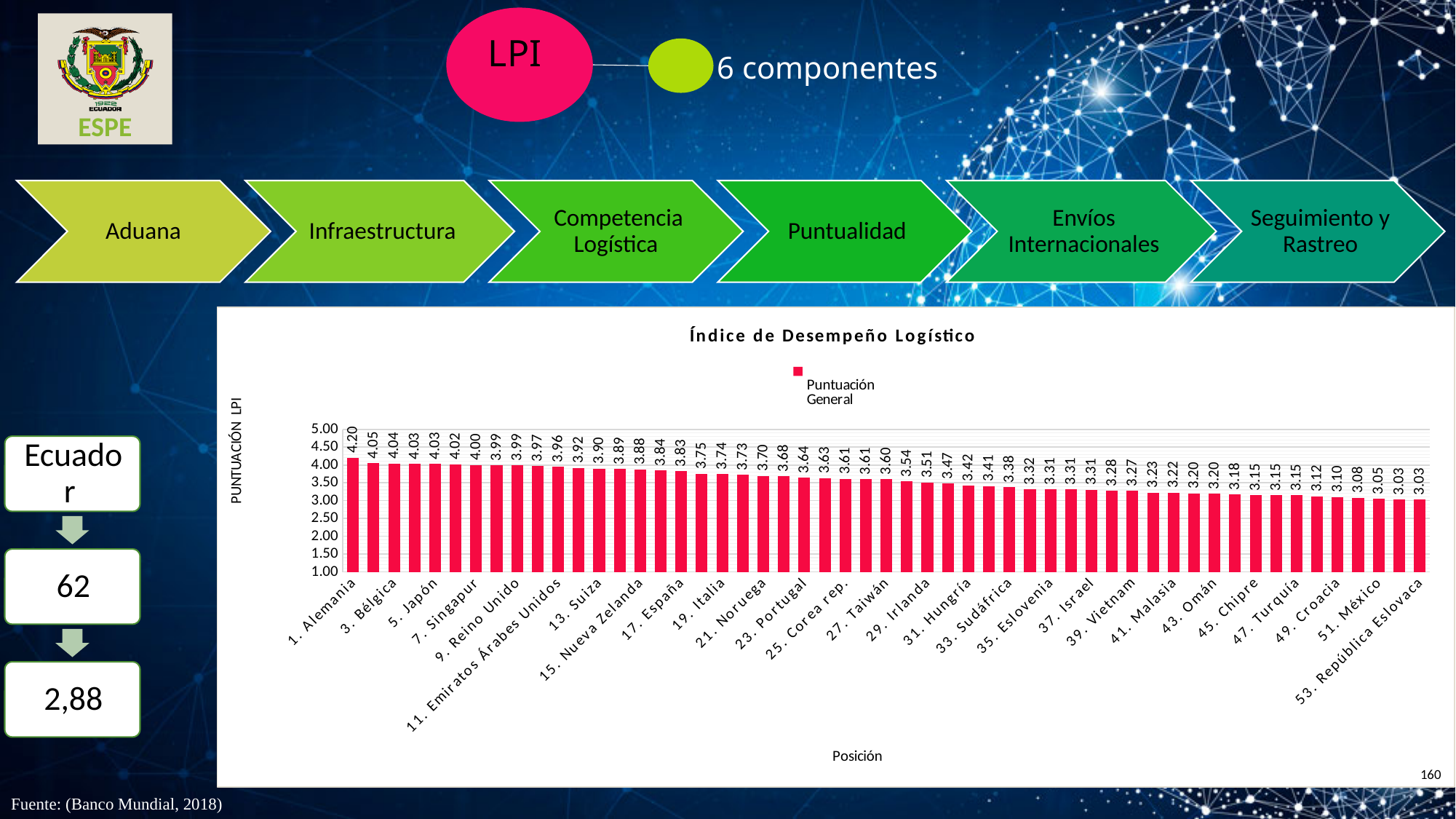
What is the title of the chart? Índice de Desempeño Logístico How many bars (countries) are plotted in the chart? 53 How many series does the chart legend list? 1 What kind of chart is shown on the slide? bar chart What is the Puntuación General value for 53. República Eslovaca? 3.03 What is the Puntuación General value for 1. Alemania? 4.20 Which country has the highest Puntuación General? 1. Alemania What is the lowest Puntuación General value shown in the chart? 3.03 What is the Puntuación General value for 13. Suiza? 3.90 What is the name of the series shown in the legend? Puntuación General Do the values rise or fall moving from left to right along the x axis? fall What is the difference between the values for 1. Alemania and 53. República Eslovaca? 1.17